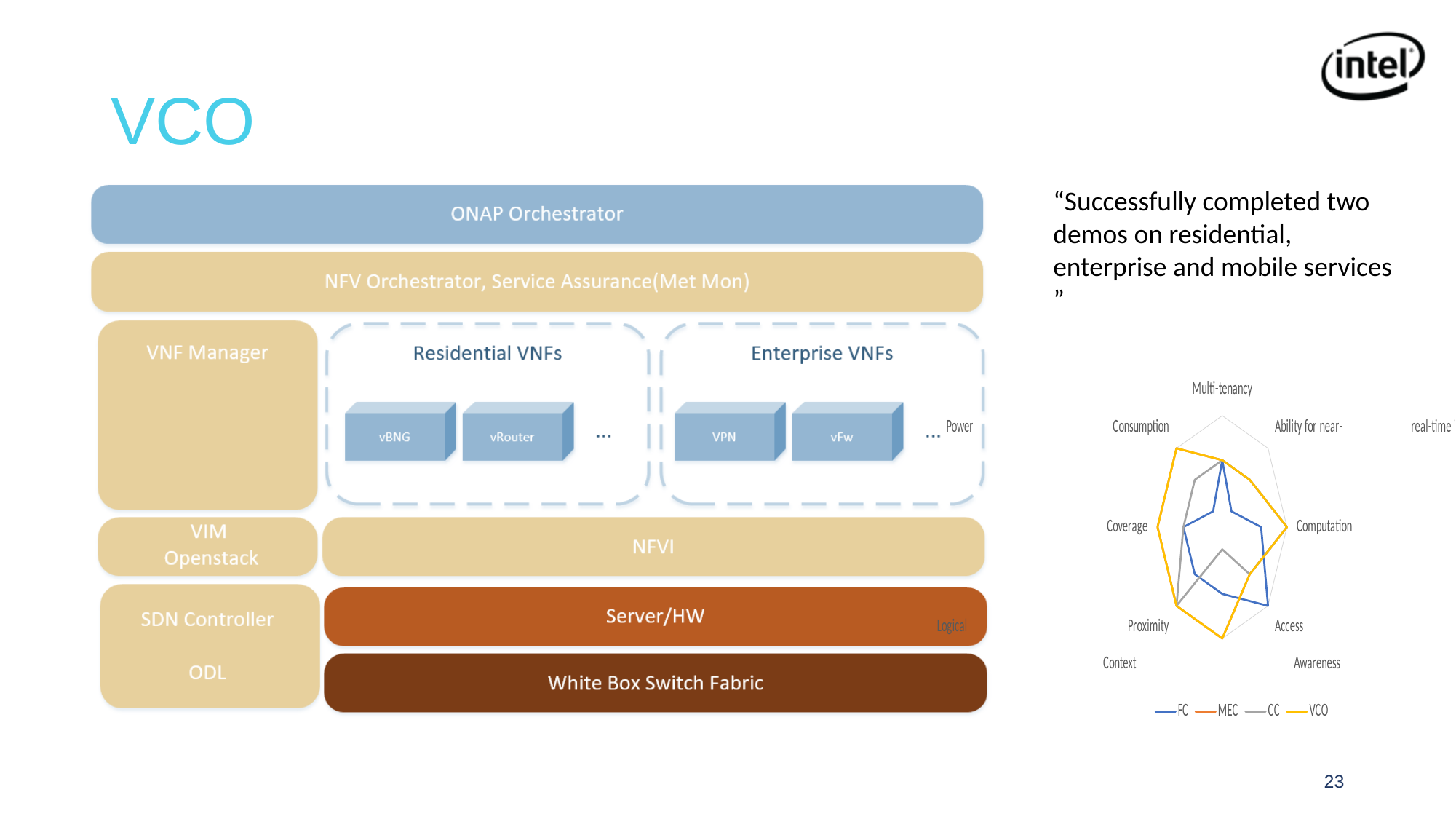
On the Proximity axis of the radar chart, which series extends further: CC or FC? CC Which series are listed in the legend of the radar chart? FC, MEC, CC, VCO How many axes (categories) does the radar chart have? 8 On the Computation axis of the radar chart, which series extends further: VCO or CC? Neither; VCO and CC reach the same point on the Computation axis On the Access axis of the radar chart, which series extends further: FC or CC? FC What kind of chart is shown on the right side of the slide? radar chart What colour is the VCO series in the radar chart? yellow How many series does the legend of the radar chart list? 4